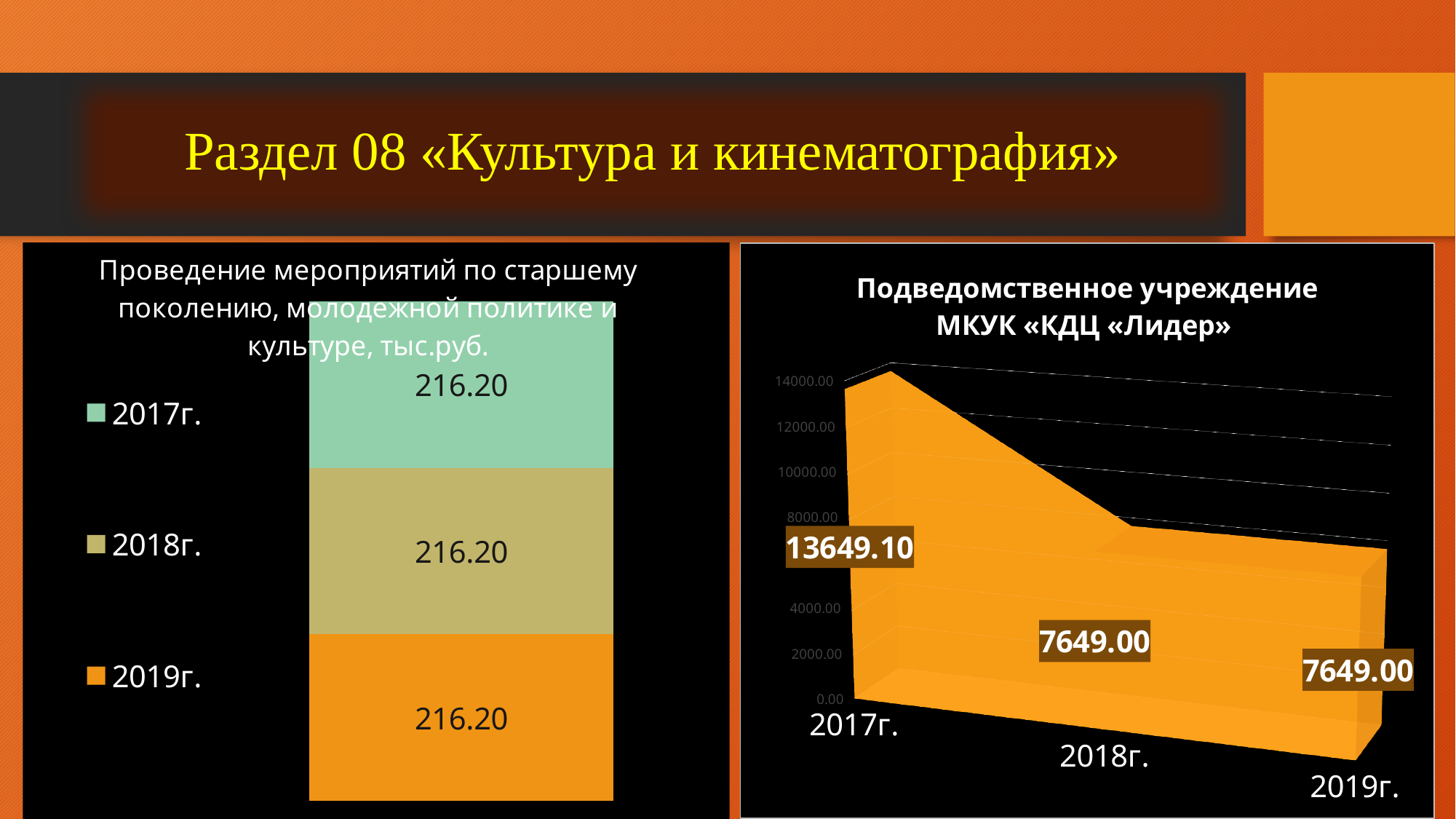
On the chart titled «Подведомственное учреждение МКУК «КДЦ «Лидер»», what is the value for 2018г.? 7649.00 On the chart titled «Подведомственное учреждение МКУК «КДЦ «Лидер»», which year has the highest value? 2017г. On the left chart, what is the value for 2019г.? 216.20 On the chart titled «Подведомственное учреждение МКУК «КДЦ «Лидер»», do the values rise or fall from 2017г. to 2018г.? Fall On the left chart, what is the total of the stacked bar? 648.60 What kind of chart is the left chart? Stacked bar chart On the left chart, how many series does the legend list? 3 On the chart titled «Подведомственное учреждение МКУК «КДЦ «Лидер»», what is the value for 2017г.? 13649.10 On the chart titled «Подведомственное учреждение МКУК «КДЦ «Лидер»», how many years are plotted? 3 On the chart titled «Подведомственное учреждение МКУК «КДЦ «Лидер»», what is the difference between the 2017г. and 2018г. values? 6000.10 On the left chart, what is the value for 2017г.? 216.20 On the left chart, what unit is given in the title? тыс.руб.